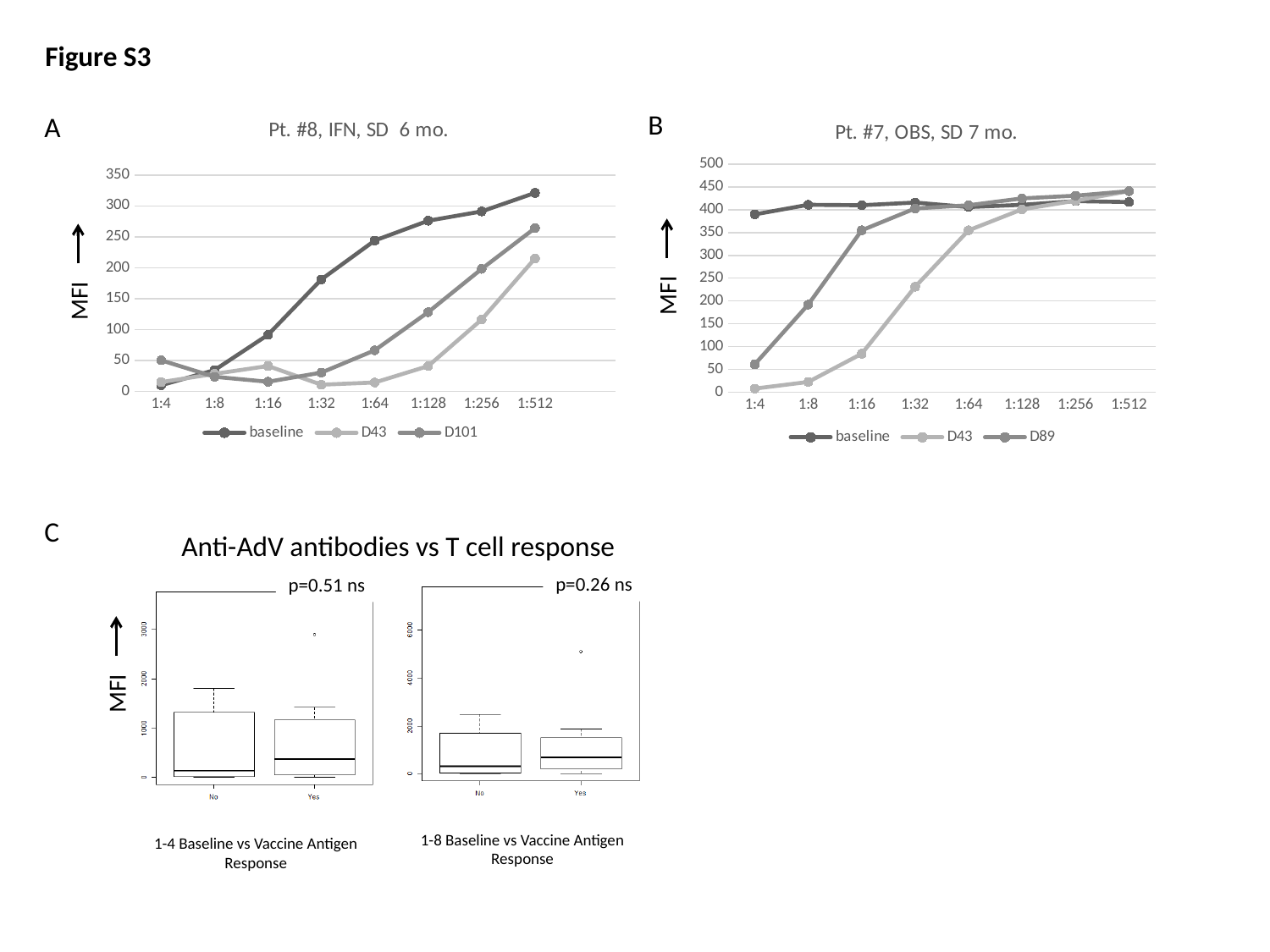
In chart A (Pt. #8, IFN, SD 6 mo.), is the D43 value at 1:512 greater or less than 250? less In chart B (Pt. #7, OBS, SD 7 mo.), which is larger at 1:8, the baseline value or the D43 value? baseline What kind of chart is chart A (Pt. #8, IFN, SD 6 mo.)? line chart In chart A (Pt. #8, IFN, SD 6 mo.), which series has the highest value at 1:512? baseline How many series does the legend of chart A (Pt. #8, IFN, SD 6 mo.) list? 3 What are the legend entries of chart B (Pt. #7, OBS, SD 7 mo.)? baseline, D43, D89 In chart B (Pt. #7, OBS, SD 7 mo.), is the D43 value at 1:4 greater or less than 50? less In chart A (Pt. #8, IFN, SD 6 mo.), is the baseline value at 1:512 greater or less than 300? greater In chart A (Pt. #8, IFN, SD 6 mo.), does the D101 series rise or fall from 1:32 to 1:512? rises How many dilution categories are shown on the x axis of chart A (Pt. #8, IFN, SD 6 mo.)? 8 What is the title of the box plot panel C? Anti-AdV antibodies vs T cell response